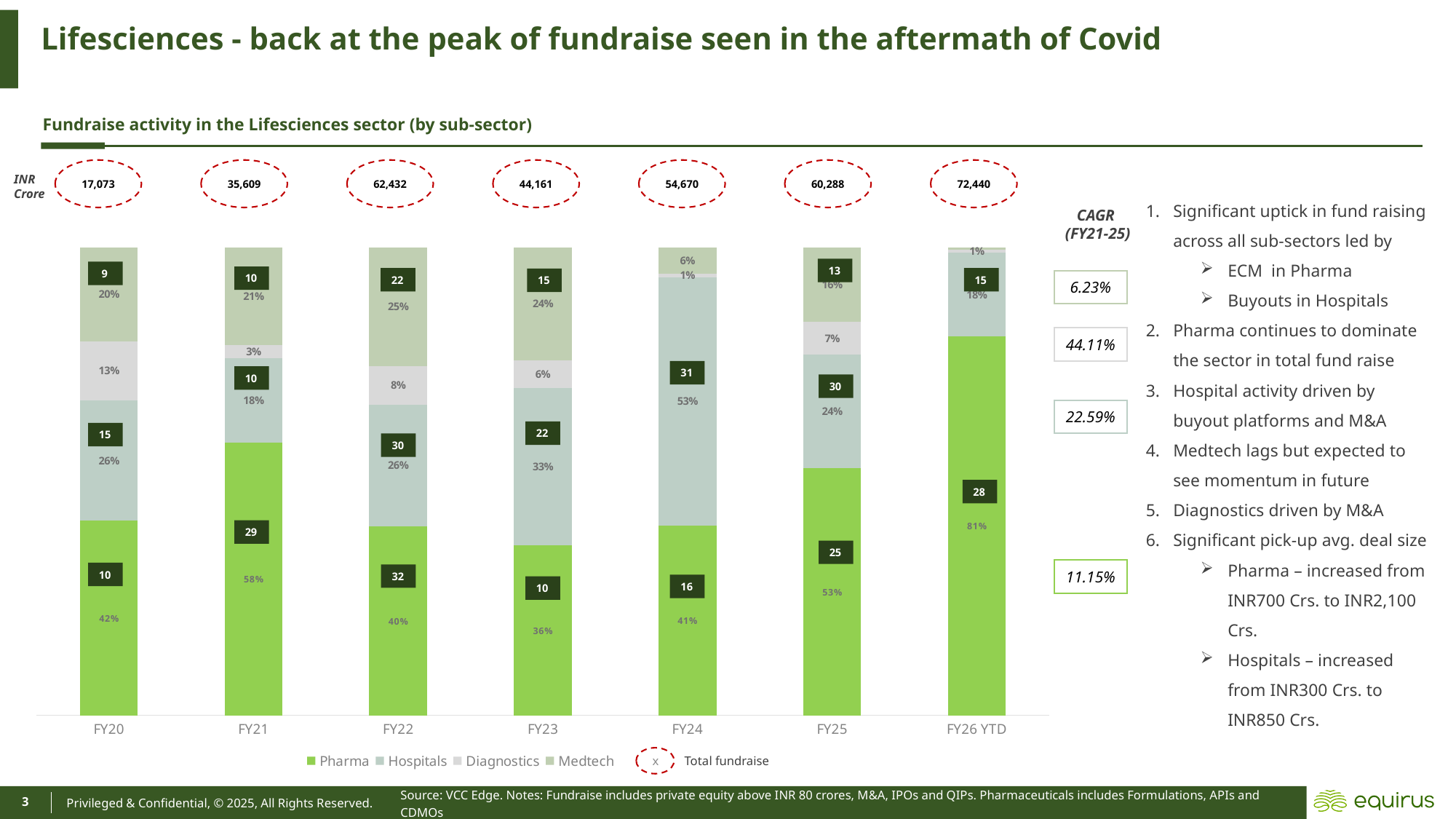
What number is shown in the dark label on the Pharma segment for FY22? 32 What is the total fundraise (INR Crore) shown for FY22? 62,432 How many sub-sector series does the legend list? 4 What percentage share do Hospitals have in FY24? 53% What percentage share does Pharma have in FY26 YTD? 81% Which fiscal year has the highest total fundraise value? FY26 YTD How many fiscal year categories are shown on the x axis? 7 What kind of chart is used to show fundraise activity by sub-sector? Stacked bar chart Which fiscal year has the lowest total fundraise value? FY20 Does the total fundraise rise or fall from FY20 to FY22? Rise What is the difference between the total fundraise in FY25 and FY24? 5,618 Which year has a larger Pharma share, FY21 or FY22? FY21